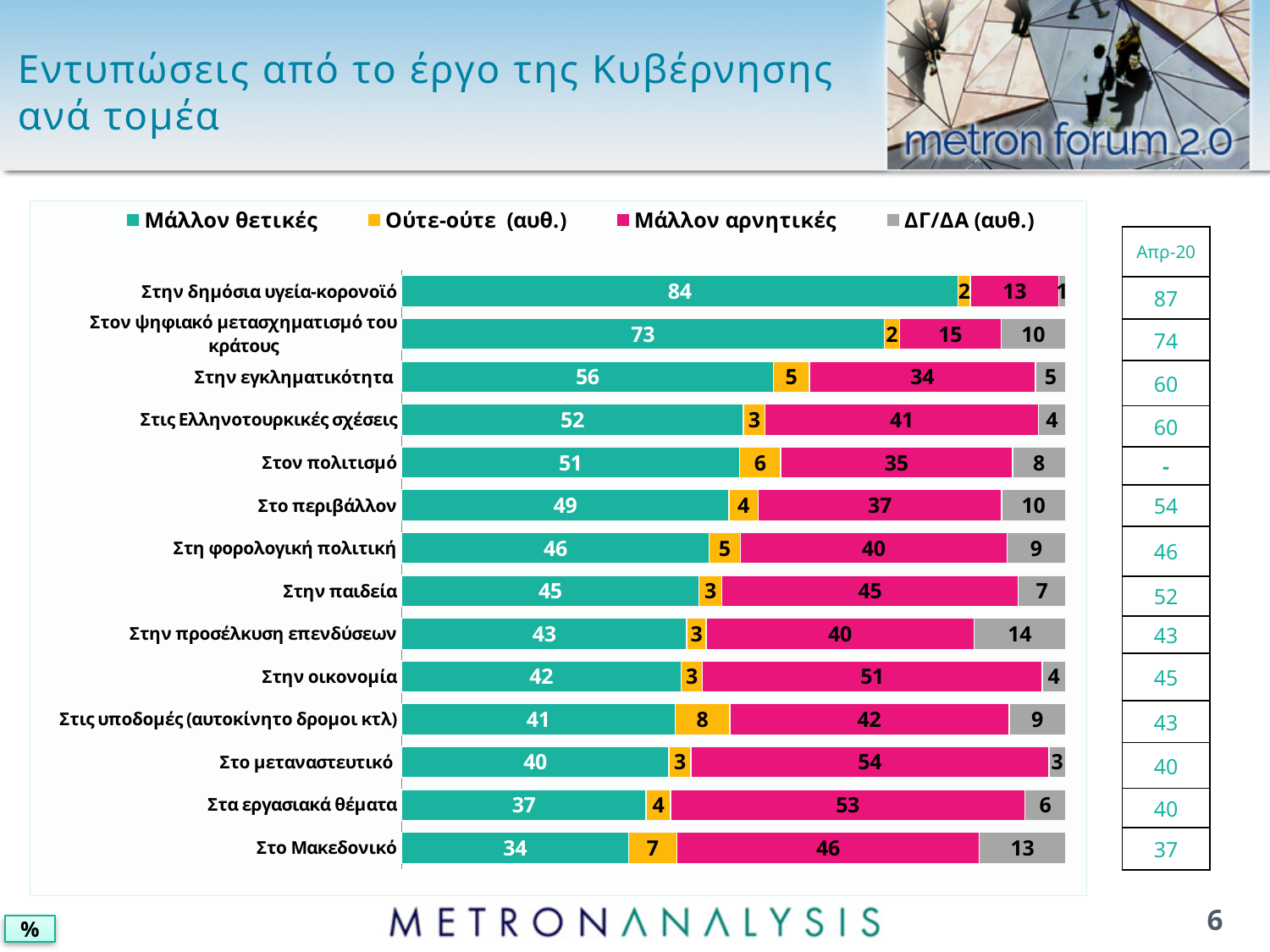
What is the total of the stacked bar for 'Στο Μακεδονικό'? 100 What type of chart is shown on the slide? Stacked bar chart What is the 'Μάλλον αρνητικές' value for 'Στο μεταναστευτικό'? 54 Which category has the lowest 'Μάλλον θετικές' value? Στο Μακεδονικό What value does the 'Απρ-20' column show for 'Στην παιδεία'? 52 What is the 'Μάλλον θετικές' value for 'Στην δημόσια υγεία-κορονοϊό'? 84 What is the 'ΔΓ/ΔΑ (αυθ.)' value for 'Στην προσέλκυση επενδύσεων'? 14 How many categories (sectors) are plotted in the chart? 14 How many series does the legend list? 4 Which category has the highest 'Μάλλον θετικές' value? Στην δημόσια υγεία-κορονοϊό What is the difference between the 'Μάλλον θετικές' values for 'Στην εγκληματικότητα' and 'Στην οικονομία'? 14 Which is larger: the 'Μάλλον αρνητικές' value for 'Στα εργασιακά θέματα' or for 'Στο Μακεδονικό'? Στα εργασιακά θέματα